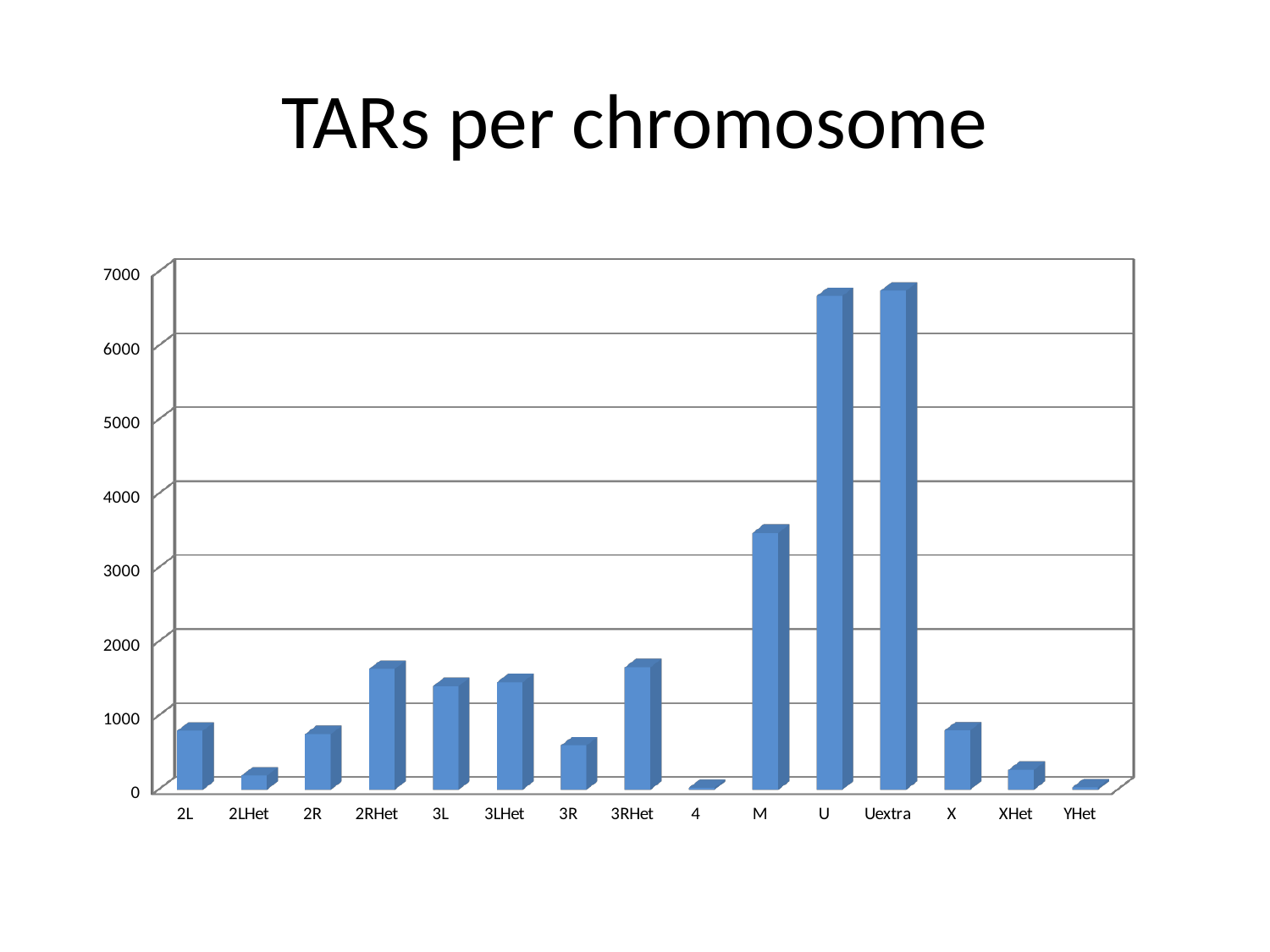
What is the title of the slide containing the chart? TARs per chromosome Which has a larger value, U or M? U Which has a larger value, M or 3RHet? M Which has a larger value, 3L or 3R? 3L Is the value for M greater or less than 3000? greater Is the value for 2RHet greater or less than 1000? greater Is the value for 3R greater or less than 1000? less What kind of chart is shown on the slide? bar chart How many chromosome categories are shown on the x axis? 15